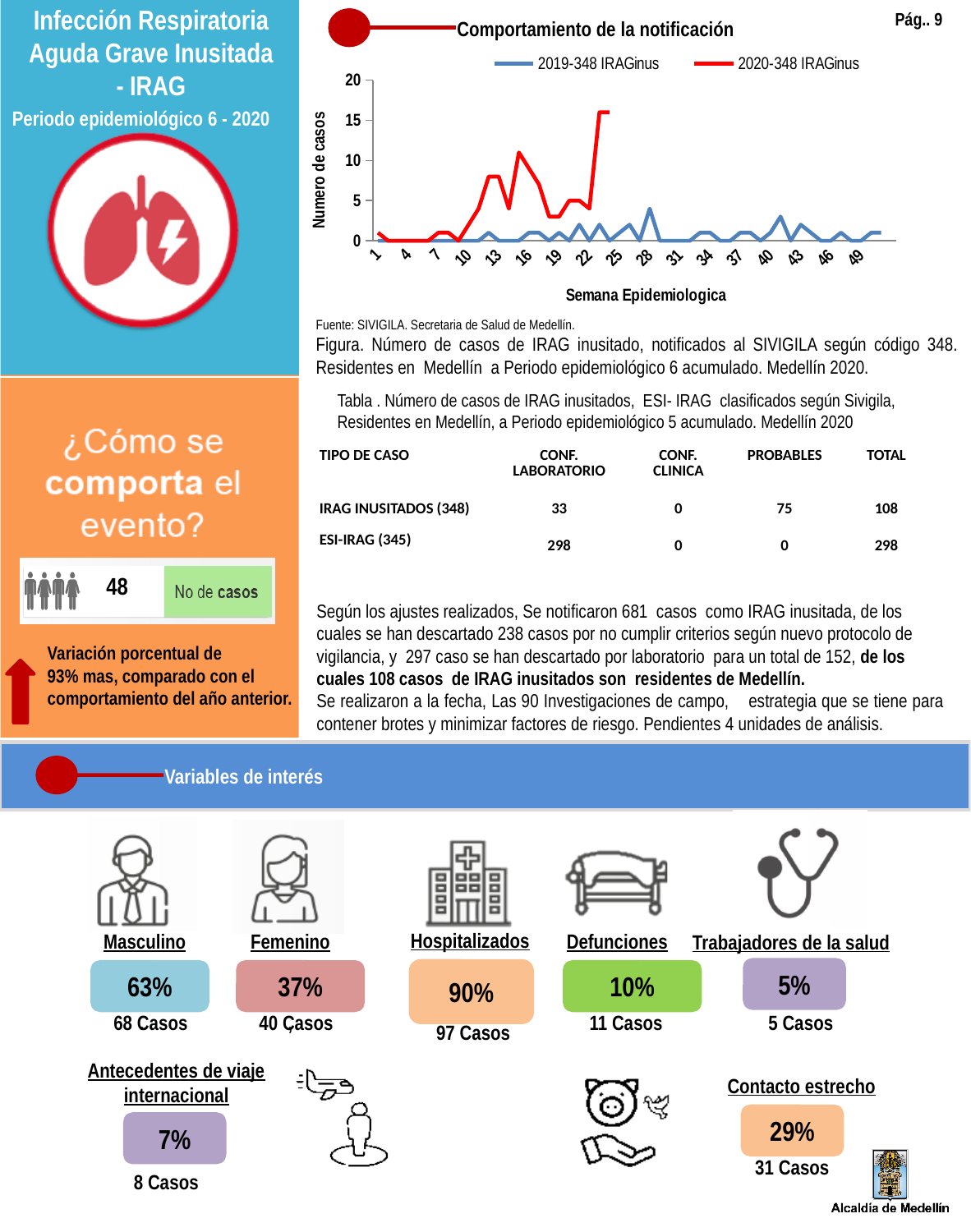
What are the two series named in the legend of the 'Comportamiento de la notificación' chart? 2019-348 IRAGinus and 2020-348 IRAGinus Which series reaches the highest value in the 'Comportamiento de la notificación' chart? 2020-348 IRAGinus What is the title of the vertical axis of the 'Comportamiento de la notificación' chart? Numero de casos In the 'Comportamiento de la notificación' chart, is the highest value of the 2019-348 IRAGinus series greater or less than 5? less In the 'Comportamiento de la notificación' chart, is the value of the 2020-348 IRAGinus series at week 13 greater or less than 5? greater How many week labels are printed on the x axis of the 'Comportamiento de la notificación' chart? 17 In the 'Comportamiento de la notificación' chart, which series has the larger value at week 22: 2019-348 IRAGinus or 2020-348 IRAGinus? 2020-348 IRAGinus How many series does the legend of the 'Comportamiento de la notificación' chart list? 2 What kind of chart is shown under the title 'Comportamiento de la notificación'? line chart In the 'Comportamiento de la notificación' chart, does the 2020-348 IRAGinus series generally rise or fall between week 10 and week 23? rise In the 'Comportamiento de la notificación' chart, is the peak value of the 2020-348 IRAGinus series greater or less than 15? greater